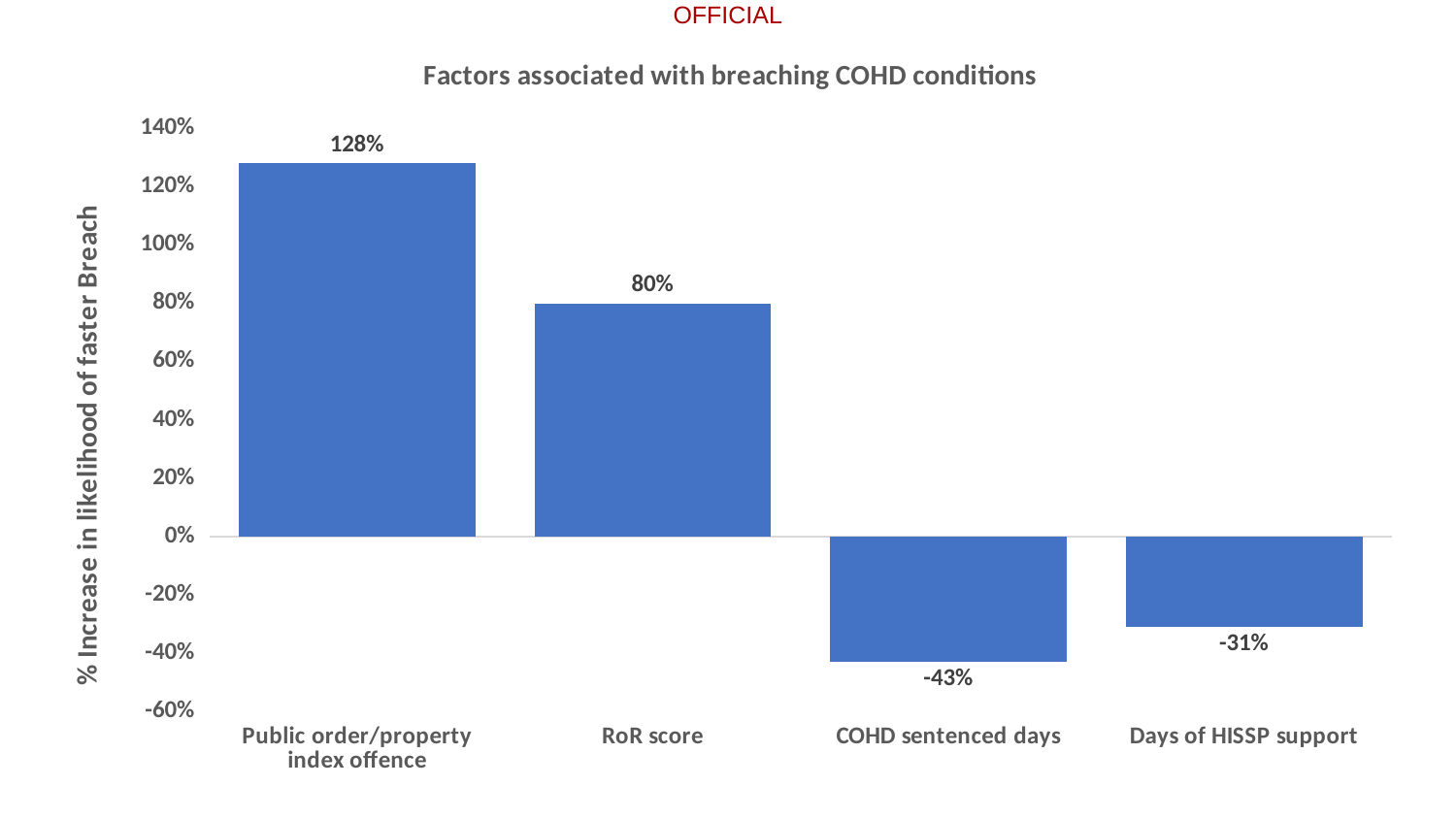
What is the title of the chart? Factors associated with breaching COHD conditions What is the value for Public order/property index offence? 128% What is the difference between the values for Public order/property index offence and RoR score? 48% What is the value for Days of HISSP support? -31% Which is larger, the value for RoR score or the value for Days of HISSP support? RoR score What is the value for RoR score? 80% Which category has the lowest value? COHD sentenced days Which category has the highest value? Public order/property index offence Is the value for RoR score greater or less than 100%? less What kind of chart is shown on the slide? Bar chart What is the value for COHD sentenced days? -43% How many categories are shown on the chart? 4